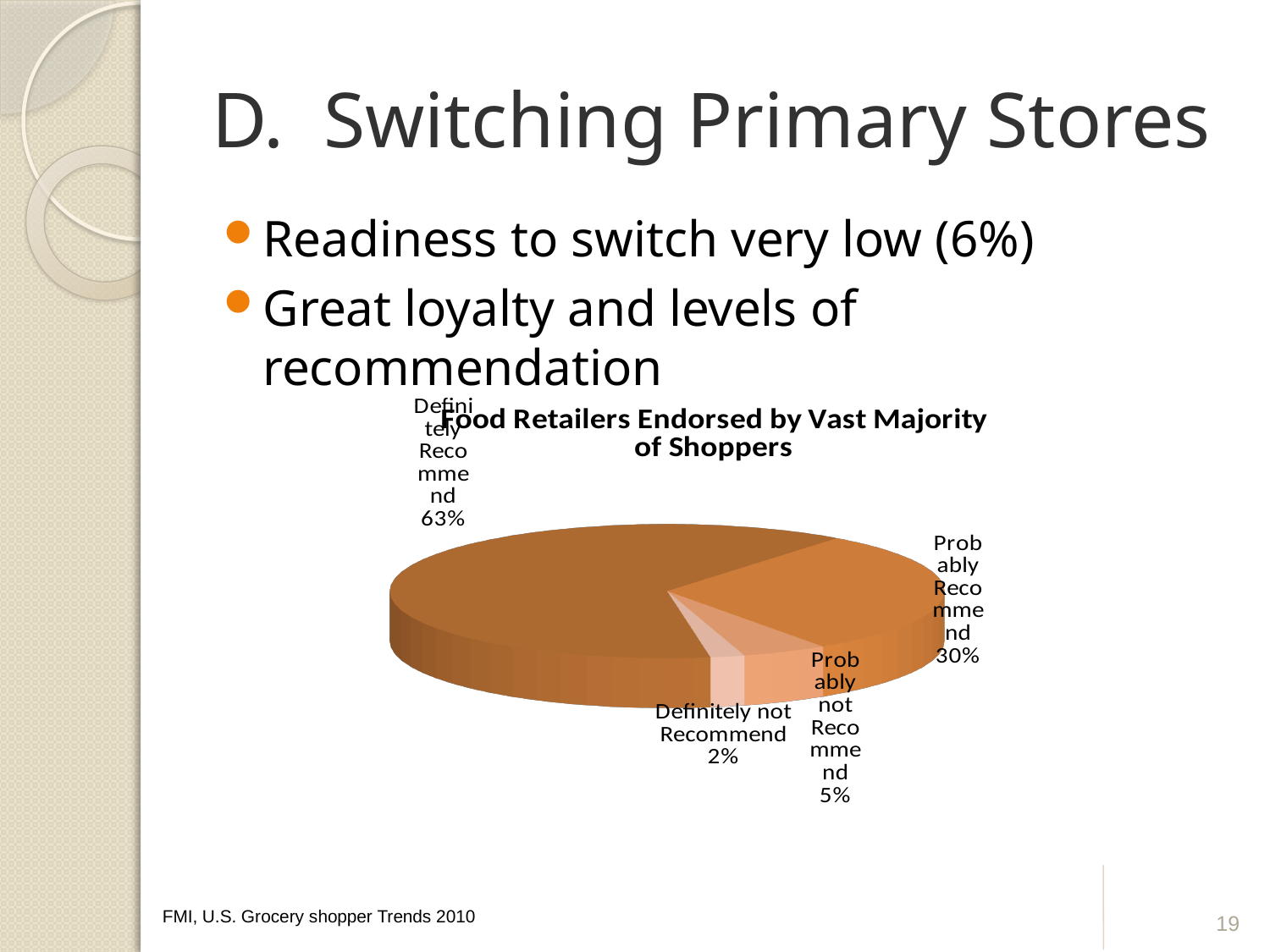
Which is larger, the share for Probably not Recommend or Definitely not Recommend? Probably not Recommend What share of shoppers would Definitely not Recommend their food retailer? 2% Which category has the smallest slice of the pie? Definitely not Recommend Which category has the largest slice of the pie? Definitely Recommend What is the difference in percentage points between Definitely Recommend and Probably Recommend? 33 What is the combined share of Definitely Recommend and Probably Recommend? 93% What share of shoppers would Probably not Recommend their food retailer? 5% What share of shoppers would Definitely Recommend their food retailer? 63% What kind of chart is shown on the slide? Pie chart How many categories are shown in the pie chart? 4 What share of shoppers would Probably Recommend their food retailer? 30% What is the title of the chart? Food Retailers Endorsed by Vast Majority of Shoppers